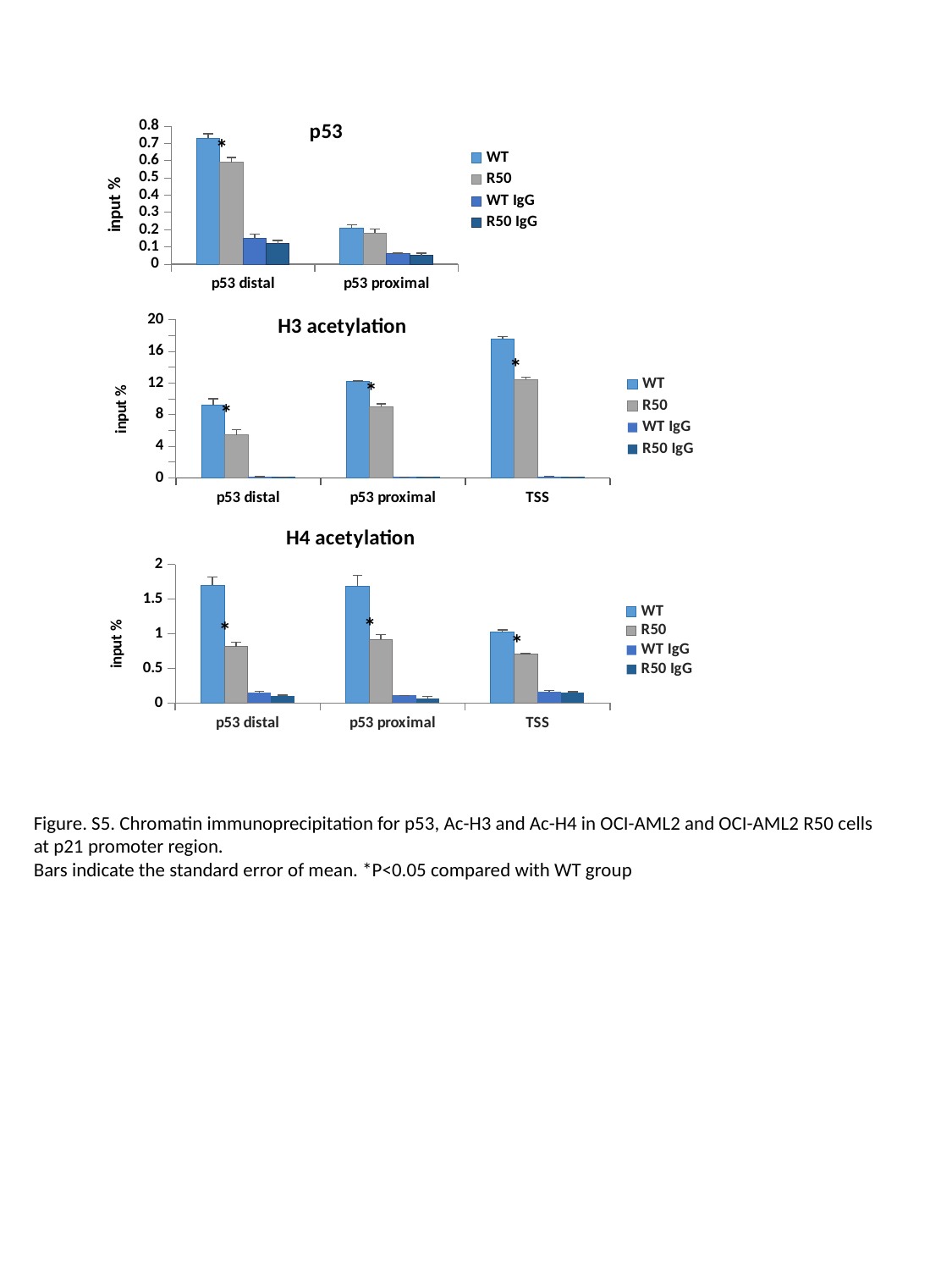
In the p53 chart, what kind of chart is used? bar chart In the H4 acetylation chart, is the value for WT at p53 distal greater or less than 1.5? greater In the H4 acetylation chart, which is larger at p53 proximal, WT or R50? WT In the H3 acetylation chart, at which category is the WT value highest? TSS In the p53 chart, is the value for WT at p53 proximal greater or less than 0.3? less In the H3 acetylation chart, is the value for WT at TSS greater or less than 16? greater How many charts are on the slide? 3 In the H4 acetylation chart, how many categories are shown on the x axis? 3 In the p53 chart, how many categories are shown on the x axis? 2 In the H3 acetylation chart, how many series does the legend list? 4